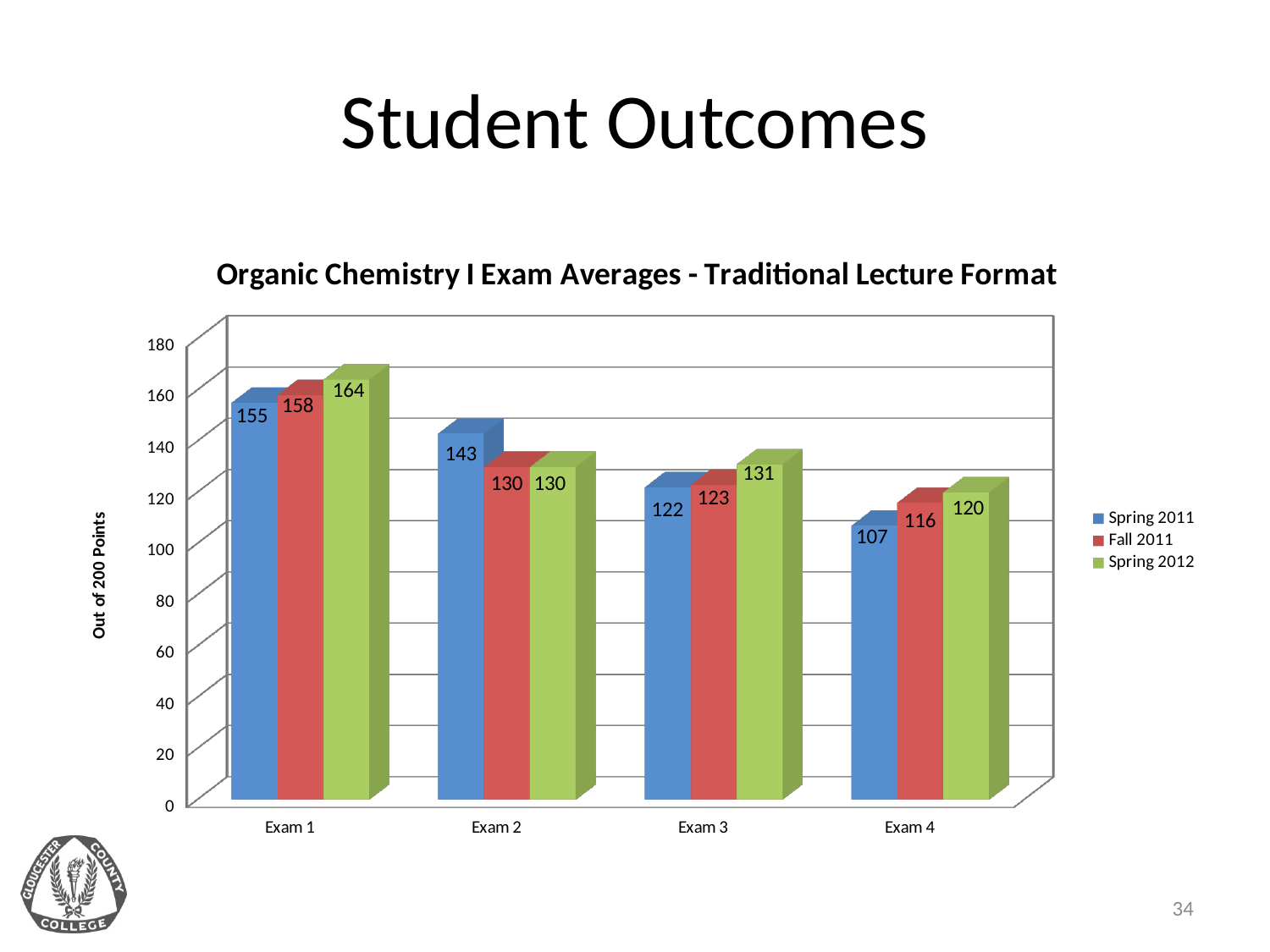
Which is larger for Exam 2: the Spring 2011 average or the Fall 2011 average? Spring 2011 How many series does the legend list? 3 What is the difference between the Spring 2012 and Spring 2011 averages for Exam 4? 13 Is the Fall 2011 average for Exam 3 greater or less than 140? less What is the Spring 2012 exam average for Exam 1? 164 How many exams are shown on the x axis? 4 What is the Spring 2011 exam average for Exam 2? 143 Which exam has the lowest Spring 2011 average? Exam 4 Which exam has the highest Spring 2012 average? Exam 1 What kind of chart is shown on the slide? bar chart What is the Fall 2011 exam average for Exam 4? 116 What is the label on the vertical axis of the chart? Out of 200 Points